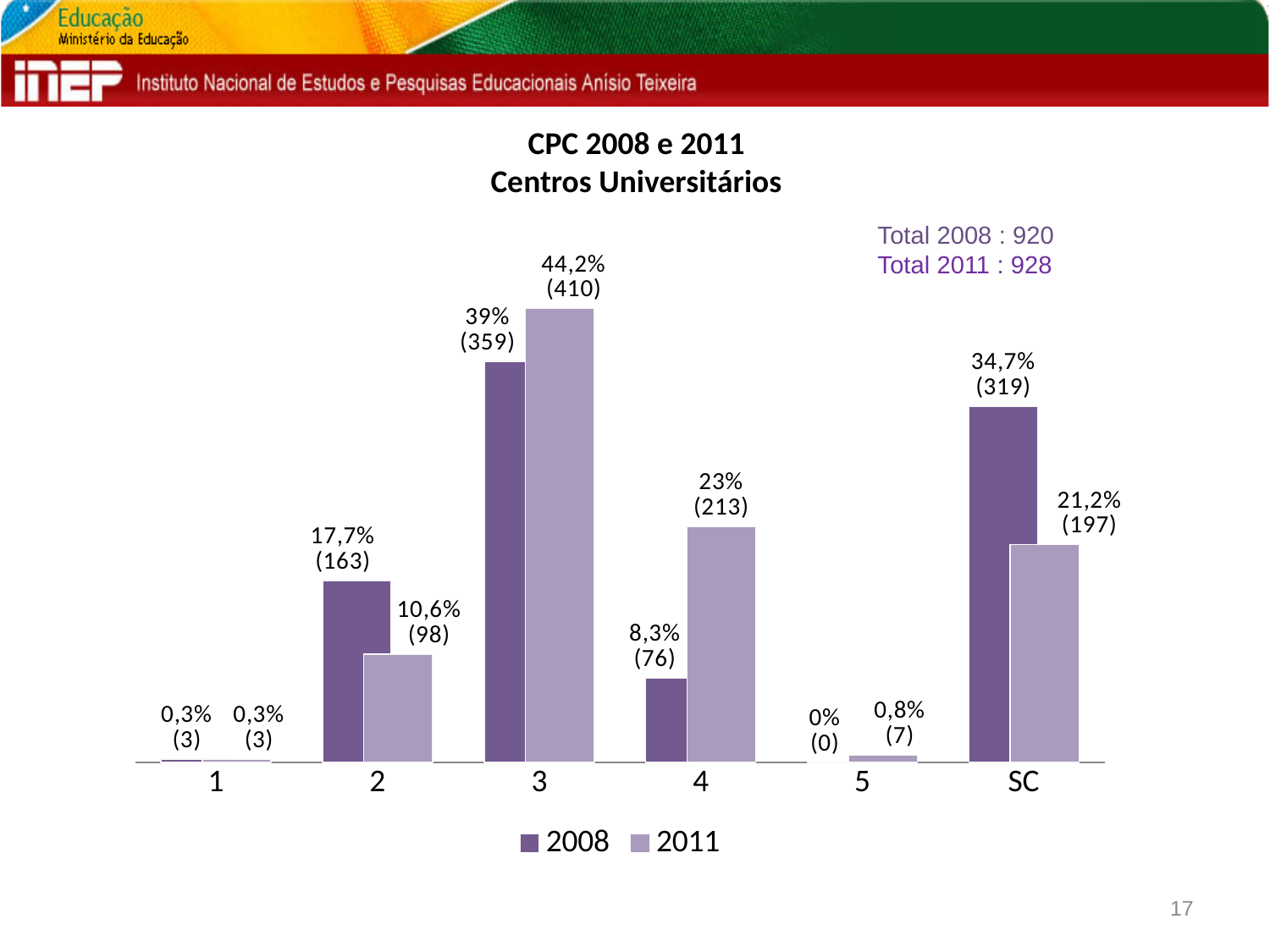
Which category has the highest value in the 2011 series? 3 What is the difference in count between 2011 and 2008 for category 4? 137 What is the title of the chart? CPC 2008 e 2011 Centros Universitários What is the value for category 4 in the 2008 series? 8,3% (76) What is the value for category SC in the 2008 series? 34,7% (319) Which is larger for category 2: the 2008 value or the 2011 value? 2008 How many categories are shown on the x axis? 6 What kind of chart is shown on the slide? Bar chart What is the value for category 3 in the 2011 series? 44,2% (410) How many series does the legend list? 2 What is the total for 2011 stated on the slide? 928 Which category has the lowest value in the 2008 series? 5